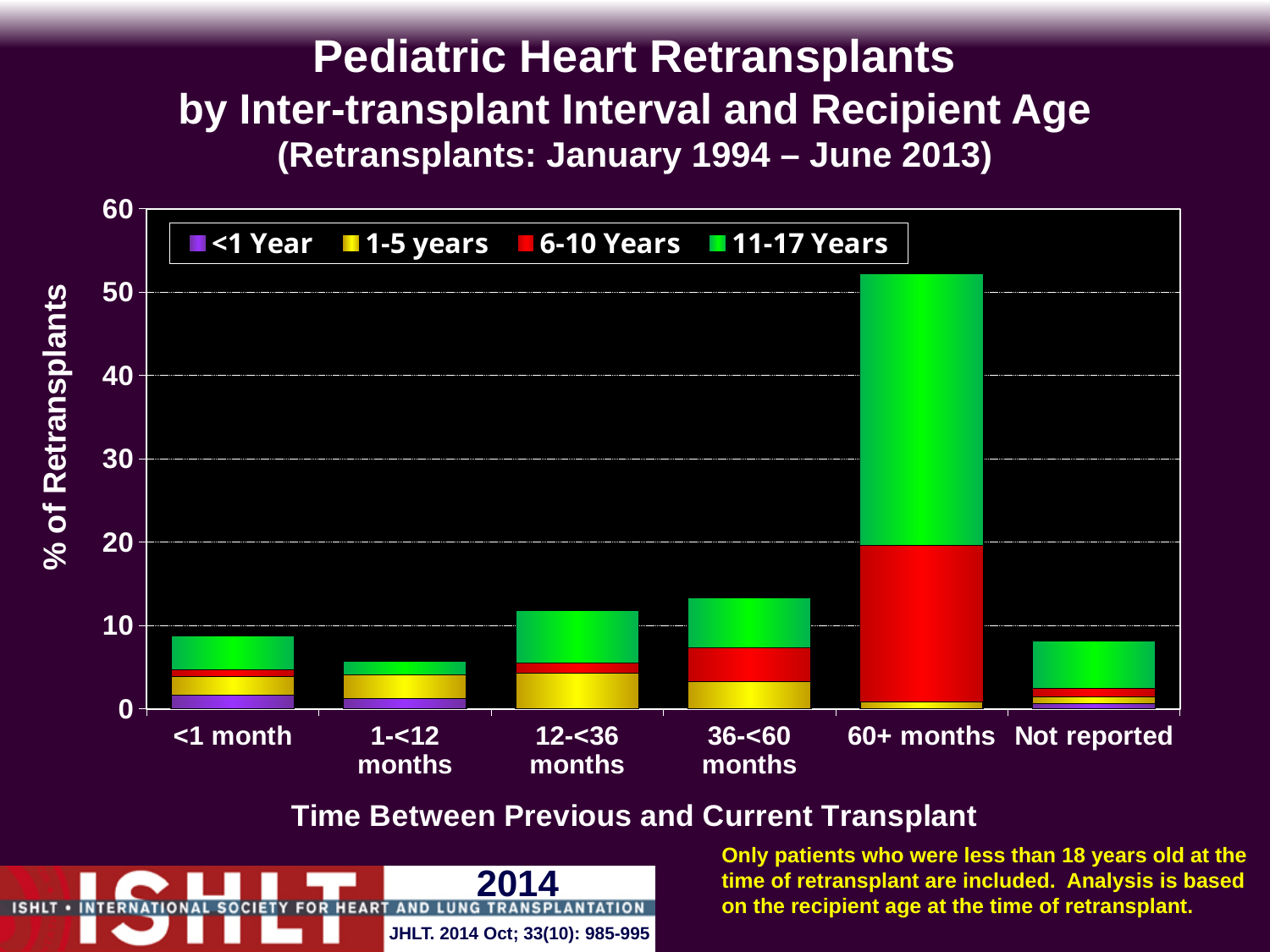
Is the total stacked bar for 60+ months greater or less than 50? greater How many series does the legend list? 4 How many inter-transplant interval categories are shown on the x axis? 6 Is the total stacked bar for 1-<12 months greater or less than 10? less What kind of chart is shown on the slide? Stacked bar chart Is the total stacked bar for 36-<60 months greater or less than 10? greater Which inter-transplant interval category has the tallest stacked bar? 60+ months Which has the taller stacked bar, 12-<36 months or 1-<12 months? 12-<36 months What is the label of the y axis? % of Retransplants Which has the taller stacked bar, 60+ months or 36-<60 months? 60+ months Which inter-transplant interval category has the shortest stacked bar? 1-<12 months